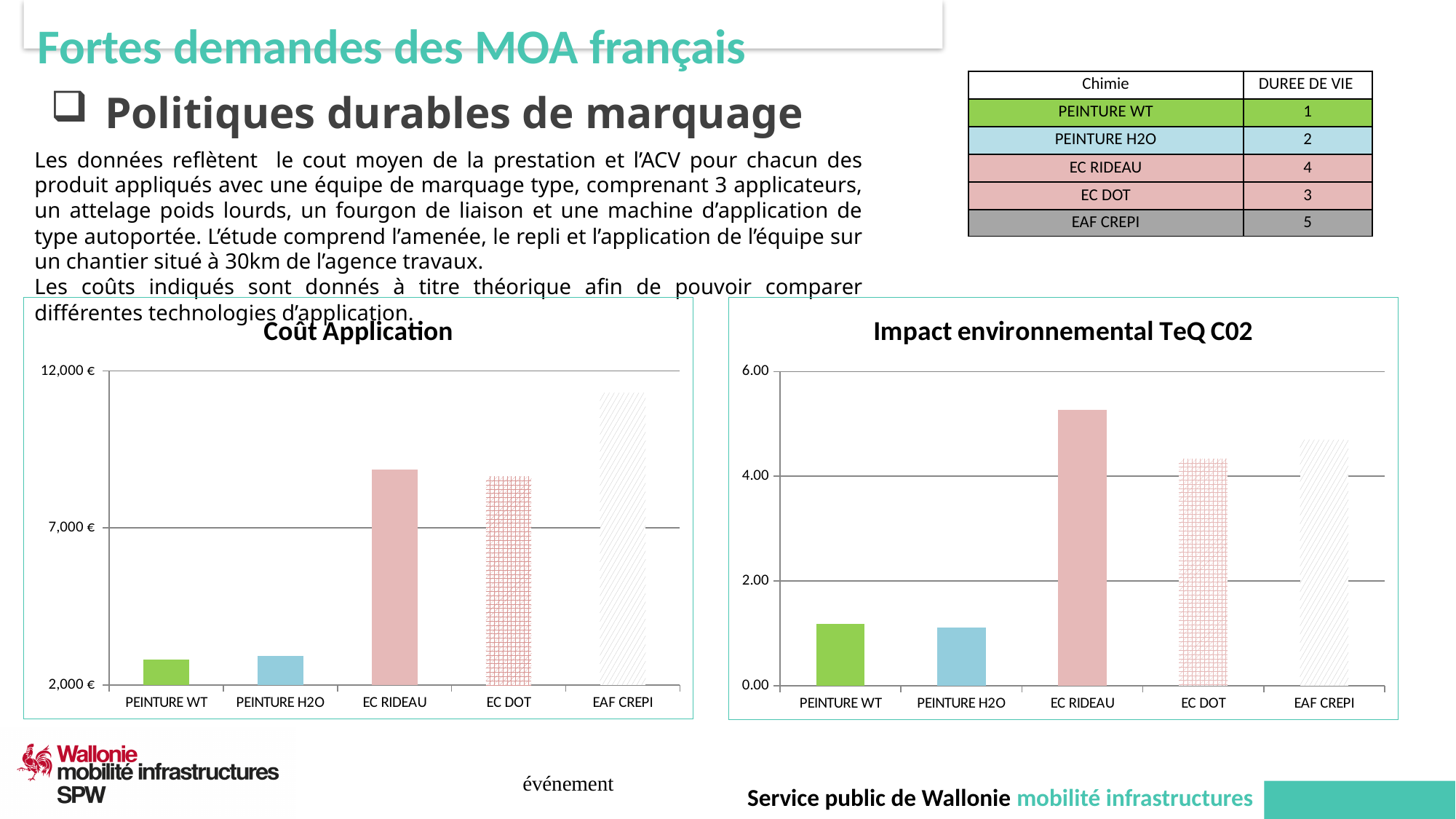
In the 'Coût Application' chart, which is larger, the value for EAF CREPI or the value for PEINTURE H2O? EAF CREPI In the 'Coût Application' chart, how many categories are shown on the x axis? 5 In the 'Coût Application' chart, is the value for EC RIDEAU greater or less than 7,000 €? greater In the 'Impact environnemental TeQ C02' chart, which category has the highest value? EC RIDEAU What type of chart is the 'Coût Application' chart? bar chart In the 'Impact environnemental TeQ C02' chart, is the value for PEINTURE WT greater or less than 2.00? less In the 'Impact environnemental TeQ C02' chart, which is larger, the value for EC RIDEAU or the value for EC DOT? EC RIDEAU In the 'Coût Application' chart, is the value for PEINTURE WT greater or less than 7,000 €? less In the 'Coût Application' chart, which category has the highest value? EAF CREPI What is the title of the chart on the right side of the slide? Impact environnemental TeQ C02 In the 'Impact environnemental TeQ C02' chart, how many categories are shown on the x axis? 5